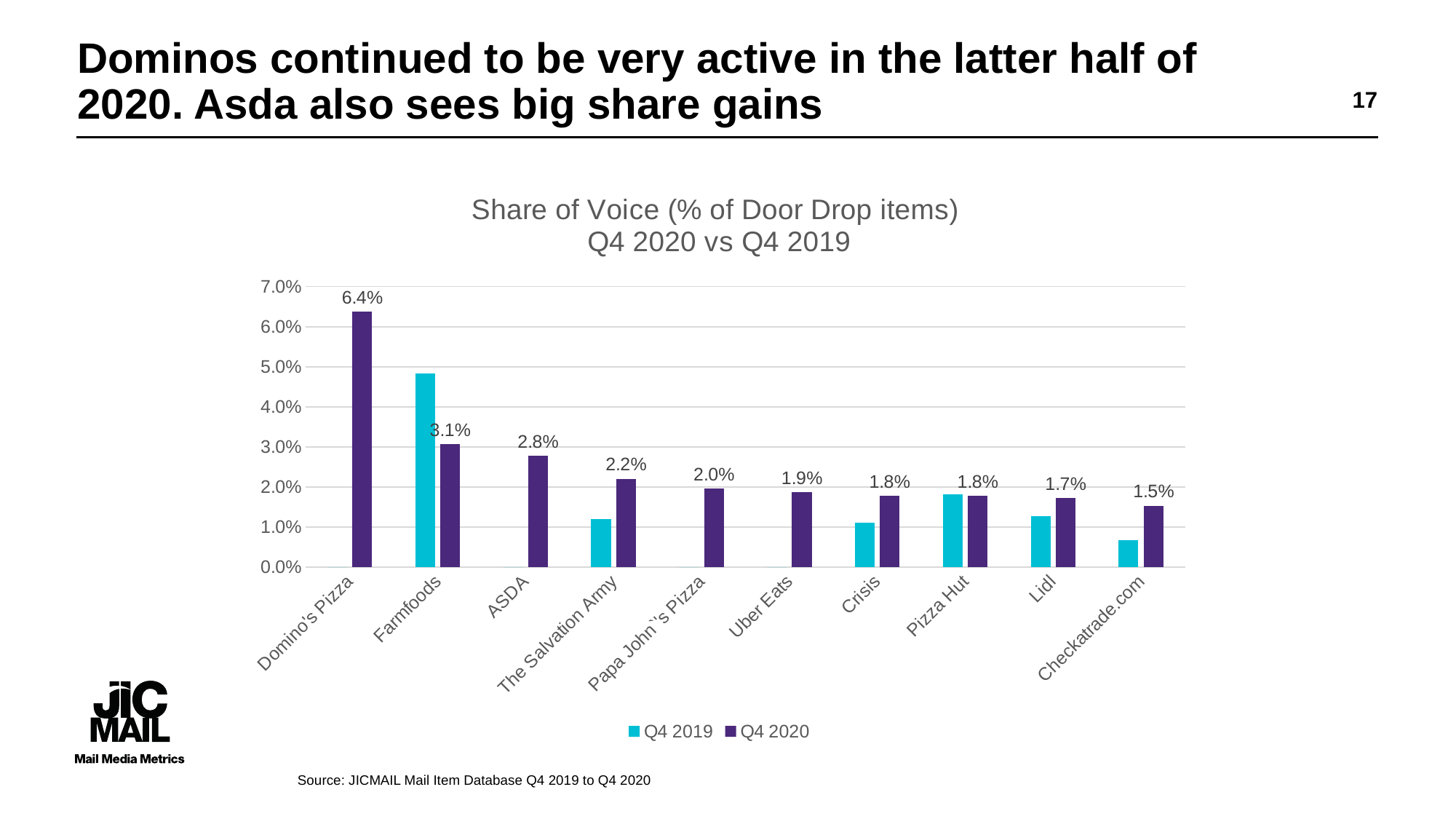
What is the difference between the Q4 2020 values for Domino's Pizza and Farmfoods? 3.3% Which brand has the highest Q4 2020 share of voice? Domino's Pizza How many series does the legend list? 2 Is the Q4 2019 value for Checkatrade.com greater or less than 1.0%? less For Farmfoods, which is larger: the Q4 2019 value or the Q4 2020 value? Q4 2019 What is the Q4 2020 share of voice for ASDA? 2.8% Which brand has the lowest Q4 2020 share of voice? Checkatrade.com What is the Q4 2020 value for Checkatrade.com? 1.5% What is the Q4 2020 share of voice for Domino's Pizza? 6.4% Is the Q4 2019 value for Farmfoods greater or less than 4.0%? greater What kind of chart is shown on the slide? Bar chart How many brands are shown on the x axis of the chart? 10